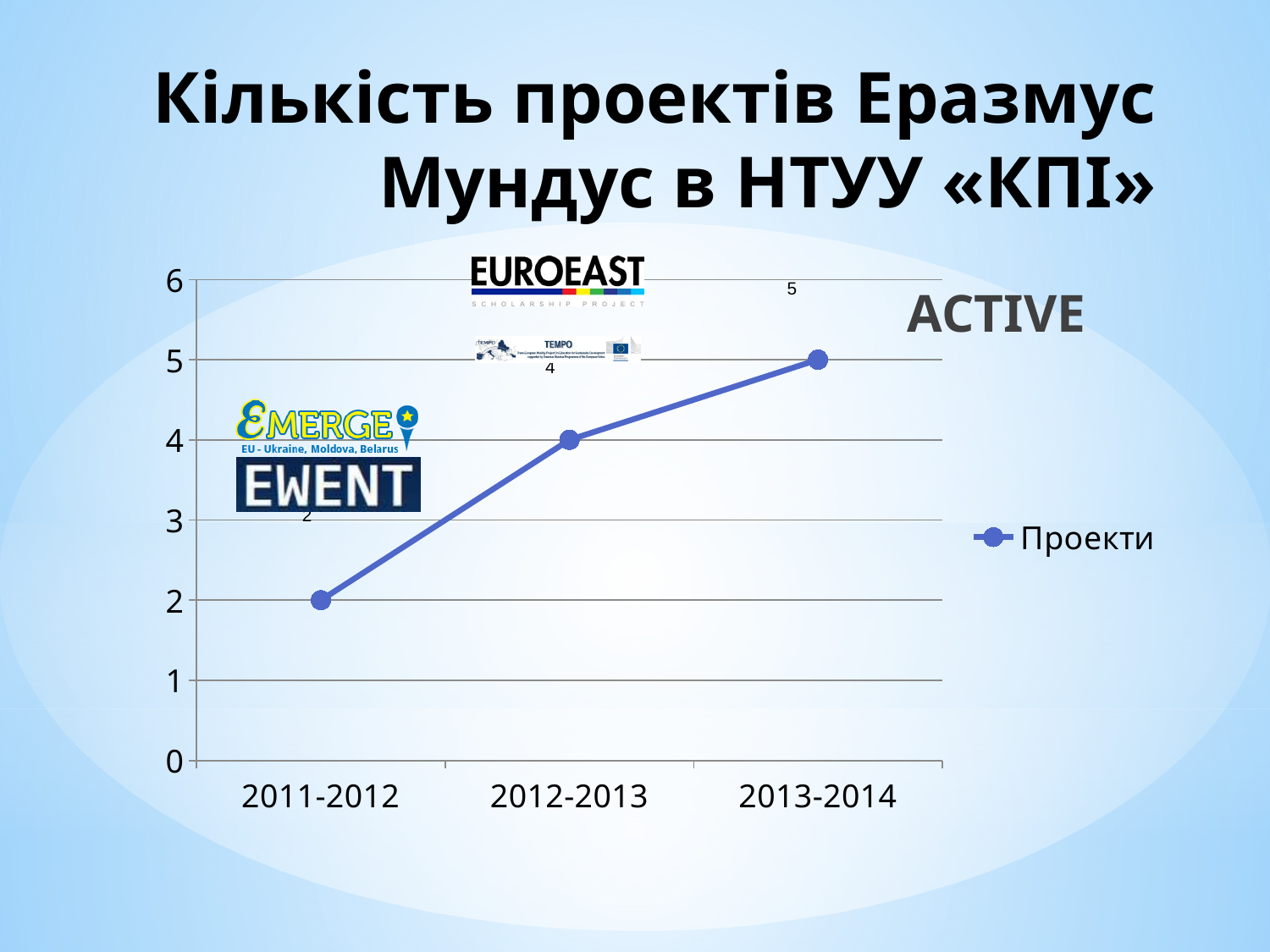
What kind of chart is shown? line chart Do the values rise or fall from 2011-2012 to 2013-2014? rise Which is larger, the value for 2012-2013 or the value for 2013-2014? 2013-2014 Which period has the highest value? 2013-2014 What is the difference between the values for 2013-2014 and 2011-2012? 3 How many series does the legend list? 1 What is the difference between the values for 2012-2013 and 2011-2012? 2 What is the value for 2013-2014? 5 What is the value for 2011-2012? 2 Which period has the lowest value? 2011-2012 How many periods are plotted on the x axis? 3 What is the value for 2012-2013? 4